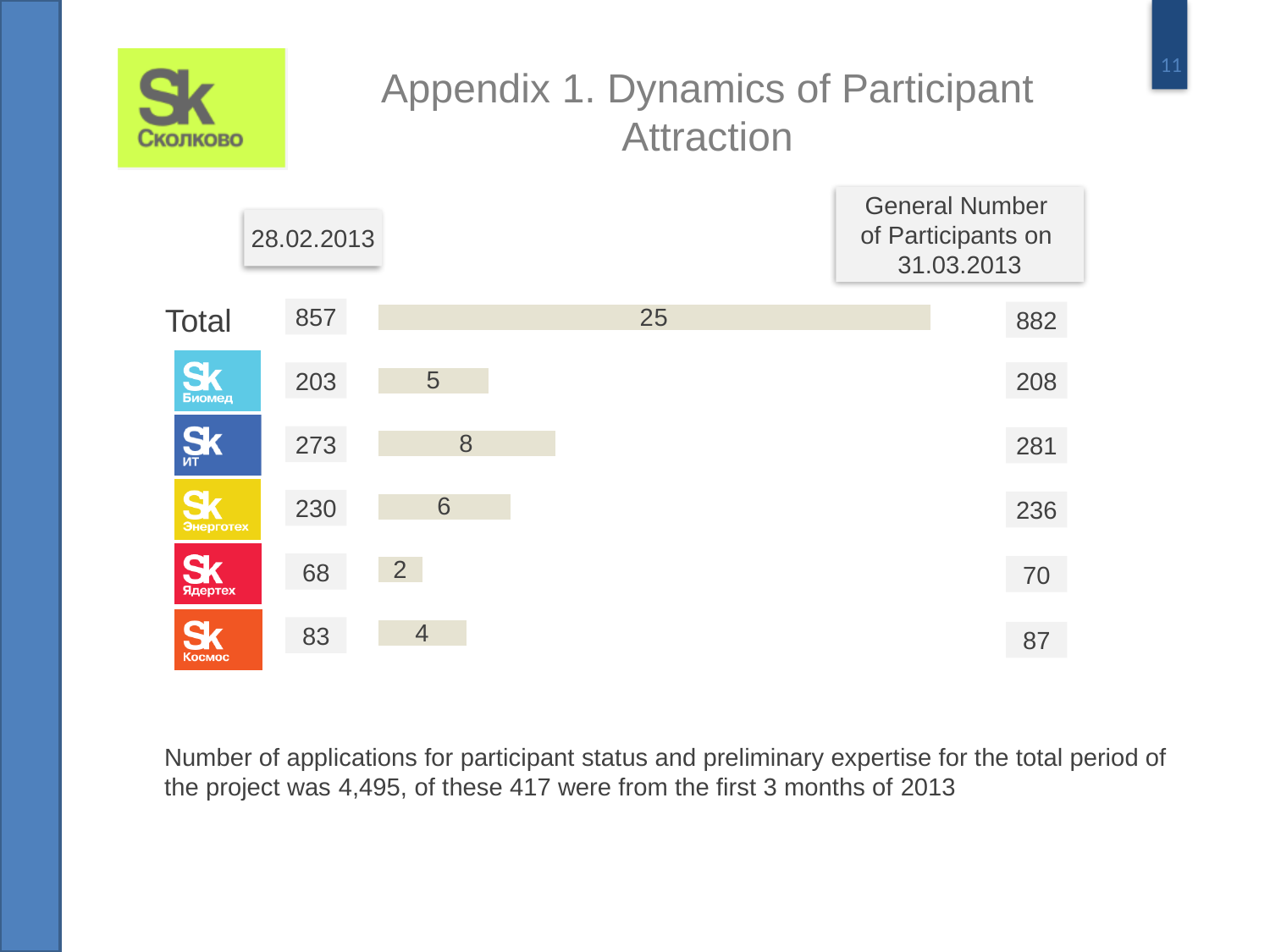
What is the General Number of Participants on 31.03.2013 for Биомед? 208 What is the Total number of participants on 31.03.2013? 882 What is the value of the bar for Космос? 4 What is the difference between the bar values for Энерготех and Биомед? 1 What was the number of participants for Энерготех on 28.02.2013? 230 Excluding the Total row, which cluster has the shortest bar? Ядертех Which has a larger bar value, Биомед or Космос? Биомед What kind of chart is shown on the slide? bar chart How many rows (including Total) are shown in the chart? 6 What is the value of the bar for ИТ? 8 What is the value of the bar for Ядертех? 2 Excluding the Total row, which cluster has the longest bar? ИТ